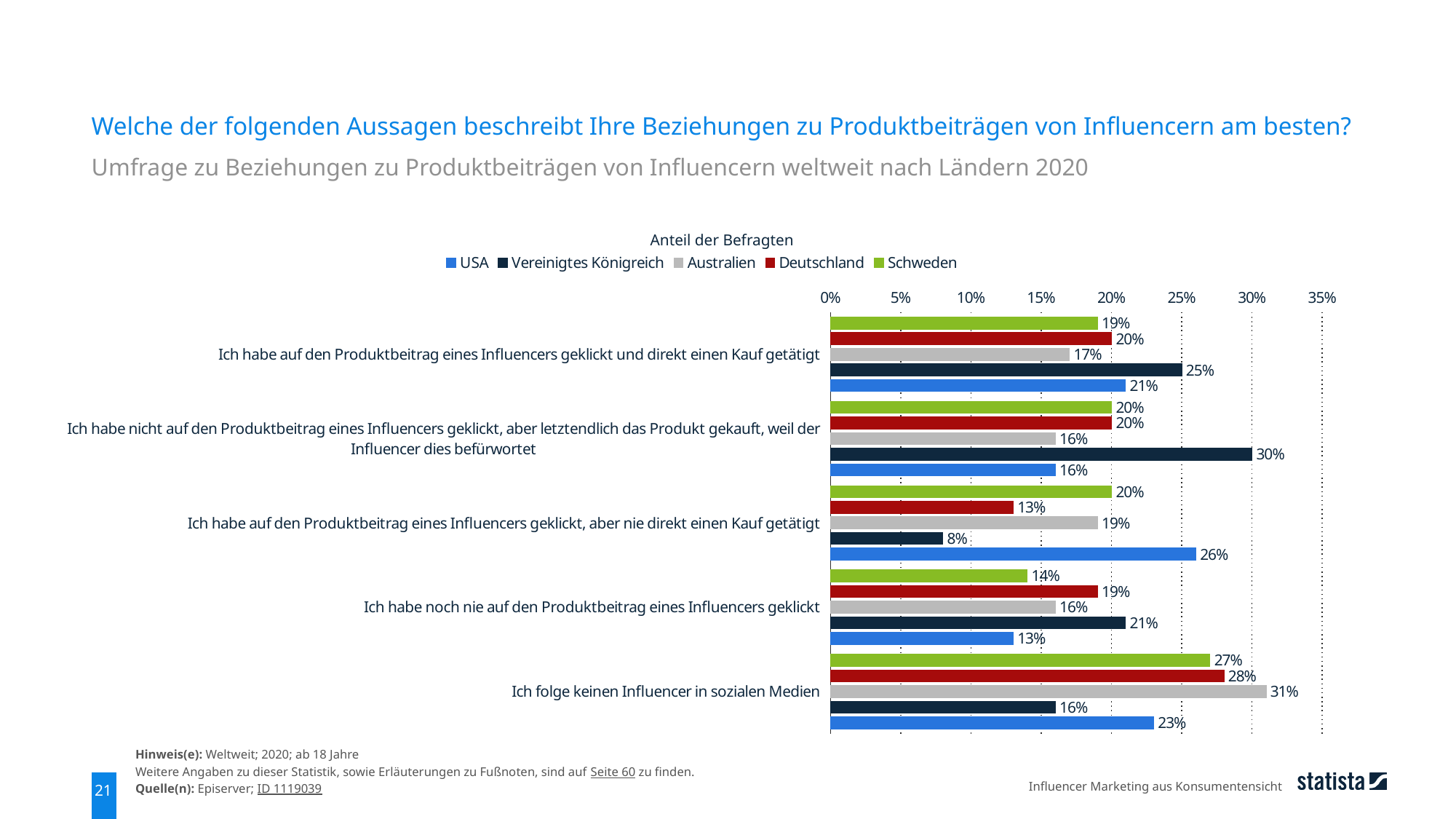
What is the value for Vereinigtes Königreich in the category "Ich habe nicht auf den Produktbeitrag eines Influencers geklickt, aber letztendlich das Produkt gekauft, weil der Influencer dies befürwortet"? 30% Which country has the highest value in the category "Ich habe auf den Produktbeitrag eines Influencers geklickt und direkt einen Kauf getätigt"? Vereinigtes Königreich How many statement categories are shown on the chart? 5 What is the difference between the Australien and Vereinigtes Königreich values in the category "Ich folge keinen Influencer in sozialen Medien"? 15% How many series does the legend list? 5 In the category "Ich habe noch nie auf den Produktbeitrag eines Influencers geklickt", which is larger: the value for Schweden or the value for Vereinigtes Königreich? Vereinigtes Königreich What is the value for Australien in the category "Ich folge keinen Influencer in sozialen Medien"? 31% What kind of chart is shown on the slide? Bar chart Which colour represents Deutschland in the chart? Red Which country has the lowest value in the category "Ich habe auf den Produktbeitrag eines Influencers geklickt, aber nie direkt einen Kauf getätigt"? Vereinigtes Königreich What is the value for USA in the category "Ich habe auf den Produktbeitrag eines Influencers geklickt, aber nie direkt einen Kauf getätigt"? 26% What is the value for Deutschland in the category "Ich habe noch nie auf den Produktbeitrag eines Influencers geklickt"? 19%